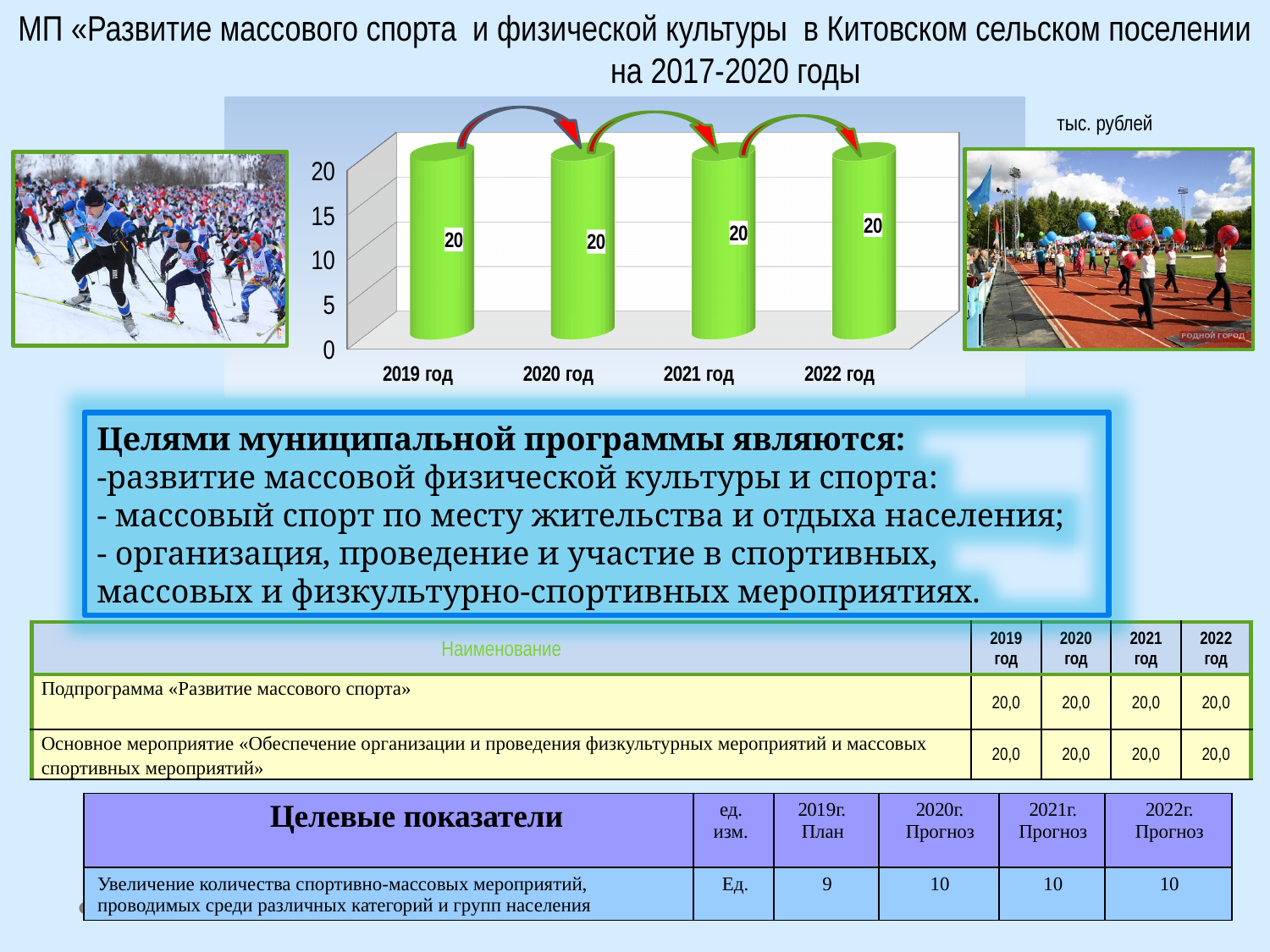
What is the value for 2021 год in the chart? 20 What is the highest value shown on the chart's vertical axis? 20 What unit is indicated next to the chart? тыс. рублей What is the value for 2019 год in the chart? 20 What kind of chart is shown on the slide? bar chart Is the value for 2021 год greater or less than 15? greater What is the value for 2022 год in the chart? 20 Do the values in the chart rise, fall or stay the same from 2019 год to 2022 год? stay the same What is the difference between the values for 2019 год and 2022 год in the chart? 0 How many categories (years) are shown on the x axis of the chart? 4 Is the value for 2020 год greater or less than 10? greater What is the value for 2020 год in the chart? 20